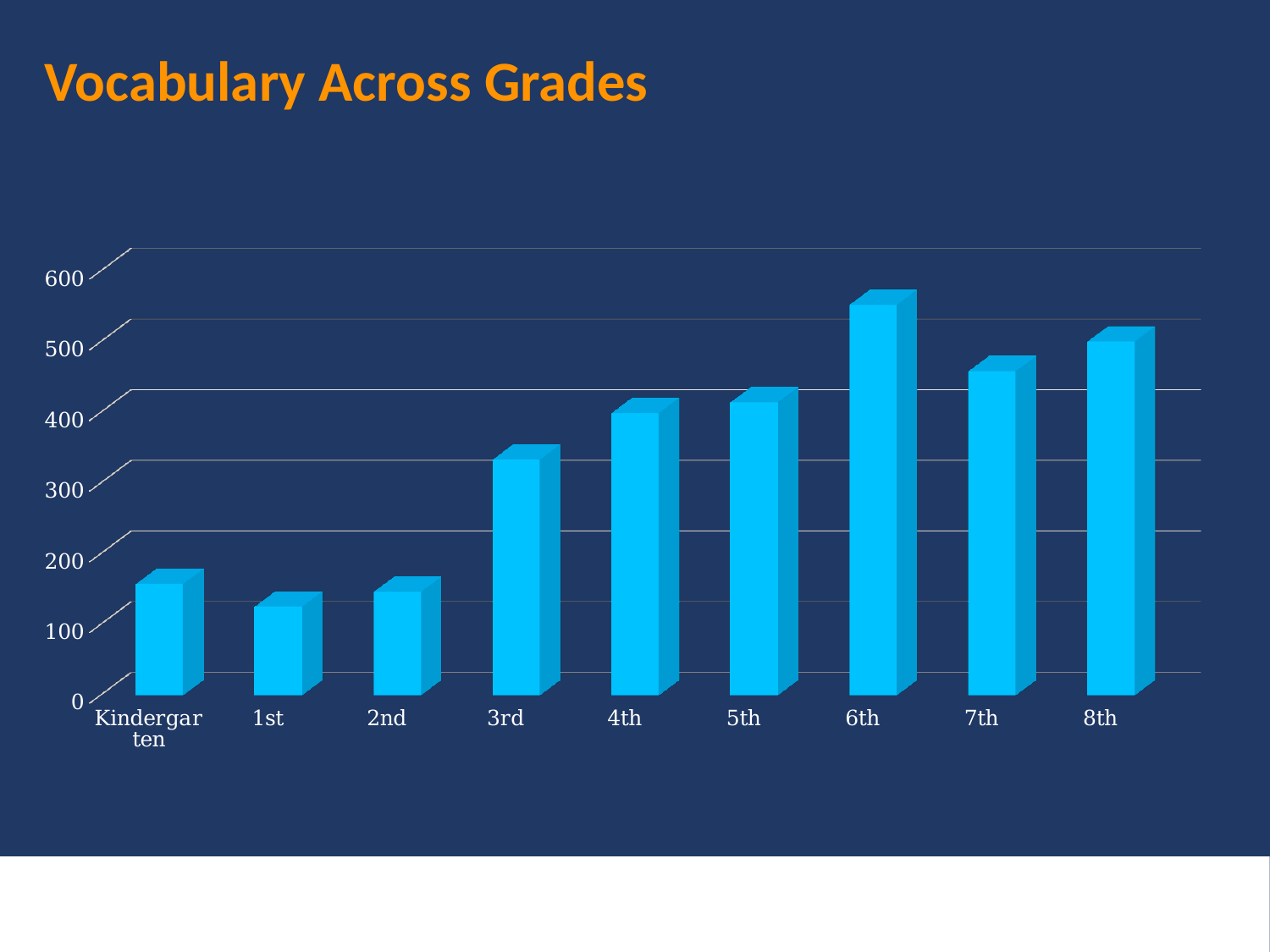
Is the value for 6th grade greater or less than 500? greater Which grade has the lowest bar? 1st How many grade categories are shown on the x axis? 9 What is the title of the chart? Vocabulary Across Grades Which is larger, the value for 3rd grade or the value for 2nd grade? 3rd Do the values generally rise or fall from Kindergarten to 6th grade? rise Is the value for 7th grade greater or less than 500? less Which is larger, the value for 6th grade or the value for 8th grade? 6th Is the value for 3rd grade greater or less than 300? greater Which grade has the highest bar? 6th What kind of chart is shown on the slide? Bar chart